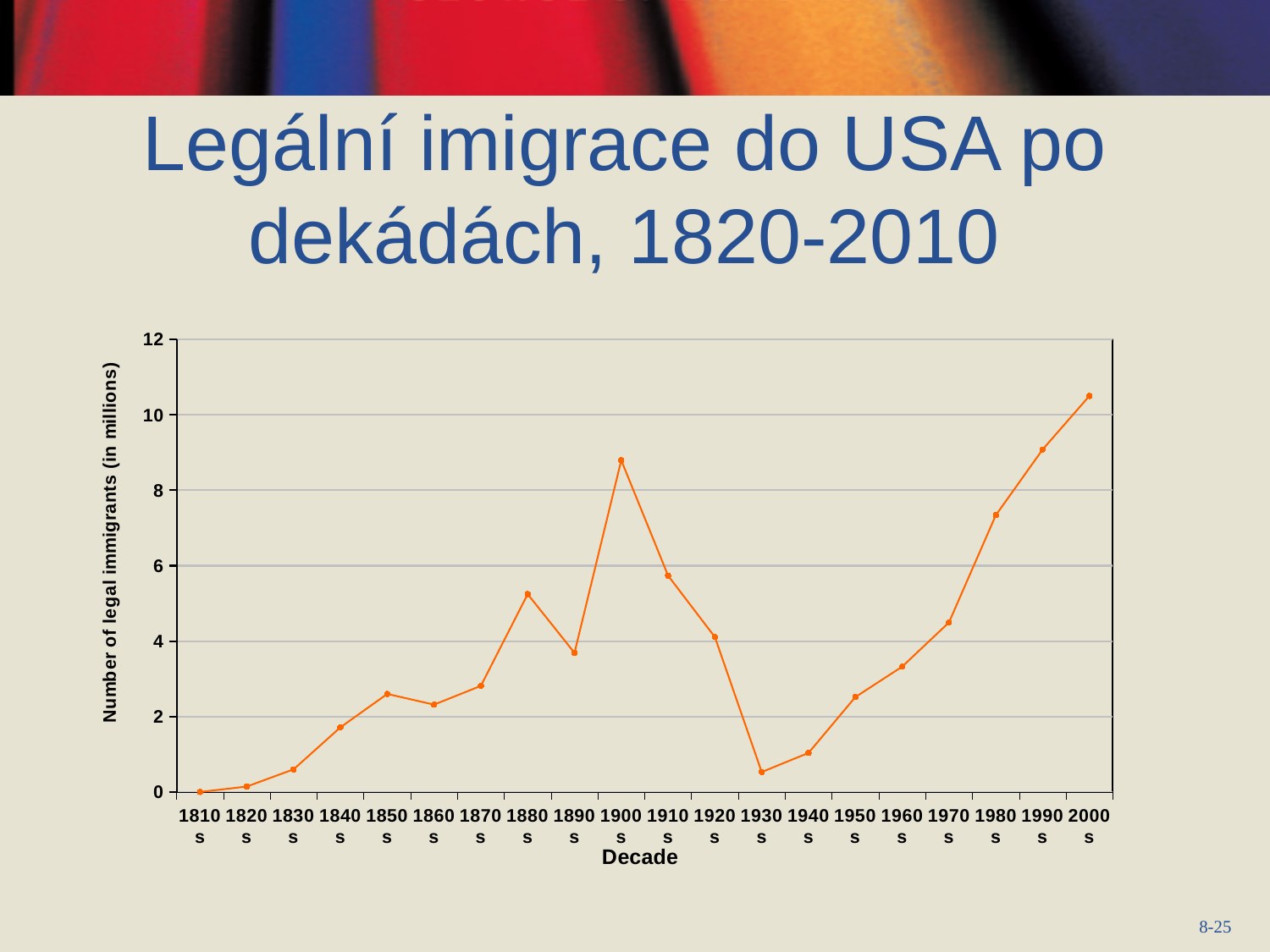
Is the value for the 1900s greater or less than 8? greater What is the title of the y axis? Number of legal immigrants (in millions) Is the value for the 1960s greater or less than 4? less Is the value for the 1980s greater or less than 6? greater How many decades are plotted on the x axis? 20 What kind of chart is shown on the slide? line chart Which decade has the lowest number of legal immigrants? 1810s Which decade has a larger value, the 1880s or the 1890s? 1880s Which decade has a larger value, the 1900s or the 1910s? 1900s Which decade has the highest number of legal immigrants? 2000s Do the values rise or fall from the 1930s to the 2000s? rise